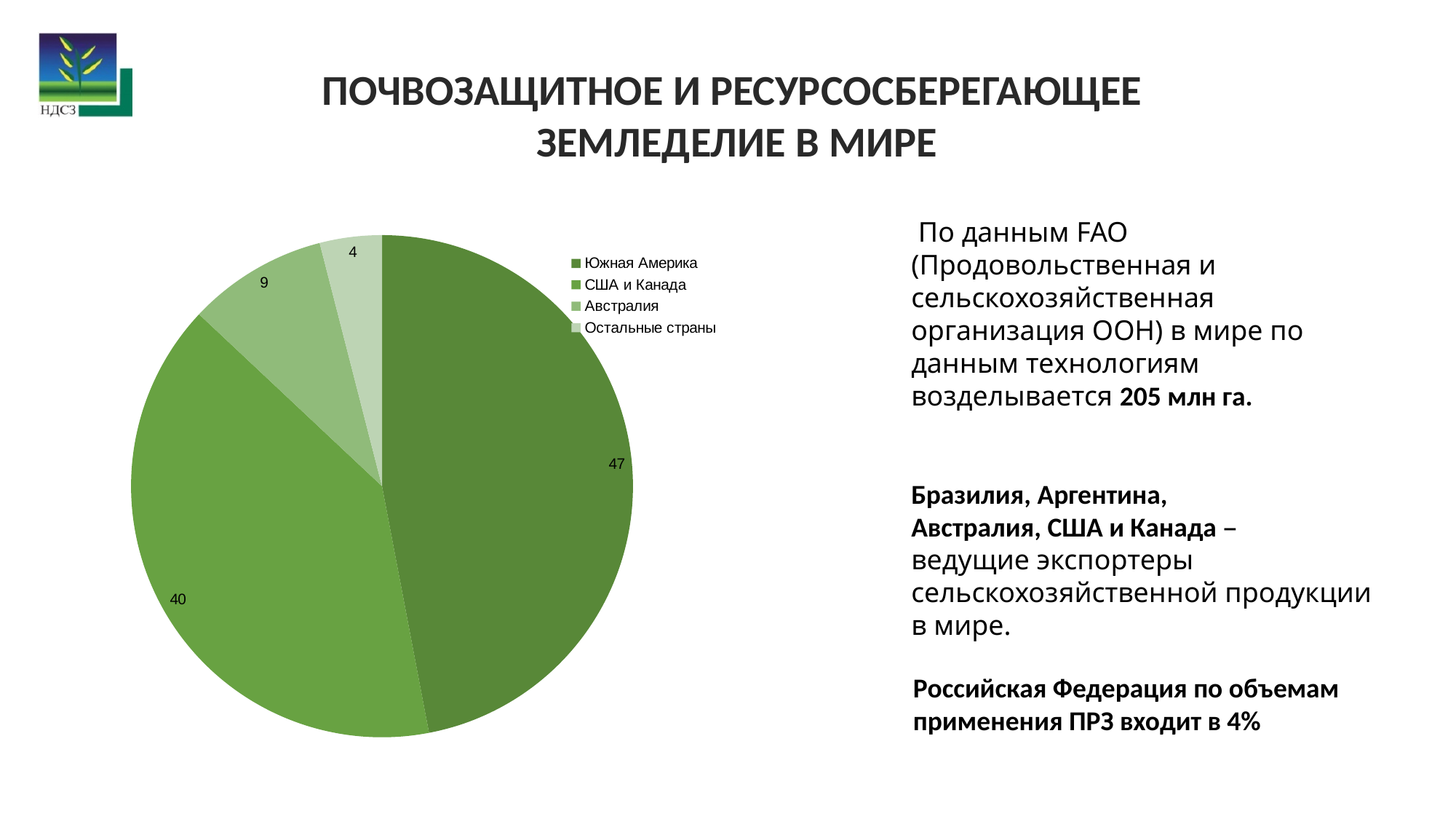
Which category has the smallest slice in the pie chart? Остальные страны What is the value shown for Южная Америка in the pie chart? 47 How many entries does the legend of the pie chart list? 4 Which category has the largest slice in the pie chart? Южная Америка Which is larger, the value for Австралия or the value for Остальные страны? Австралия What is the value shown for США и Канада in the pie chart? 40 What is the total of all the slice values in the pie chart? 100 How many slices does the pie chart have? 4 What is the difference between the values for Южная Америка and США и Канада? 7 What is the value shown for Остальные страны in the pie chart? 4 What is the value shown for Австралия in the pie chart? 9 What kind of chart is shown on the slide? pie chart